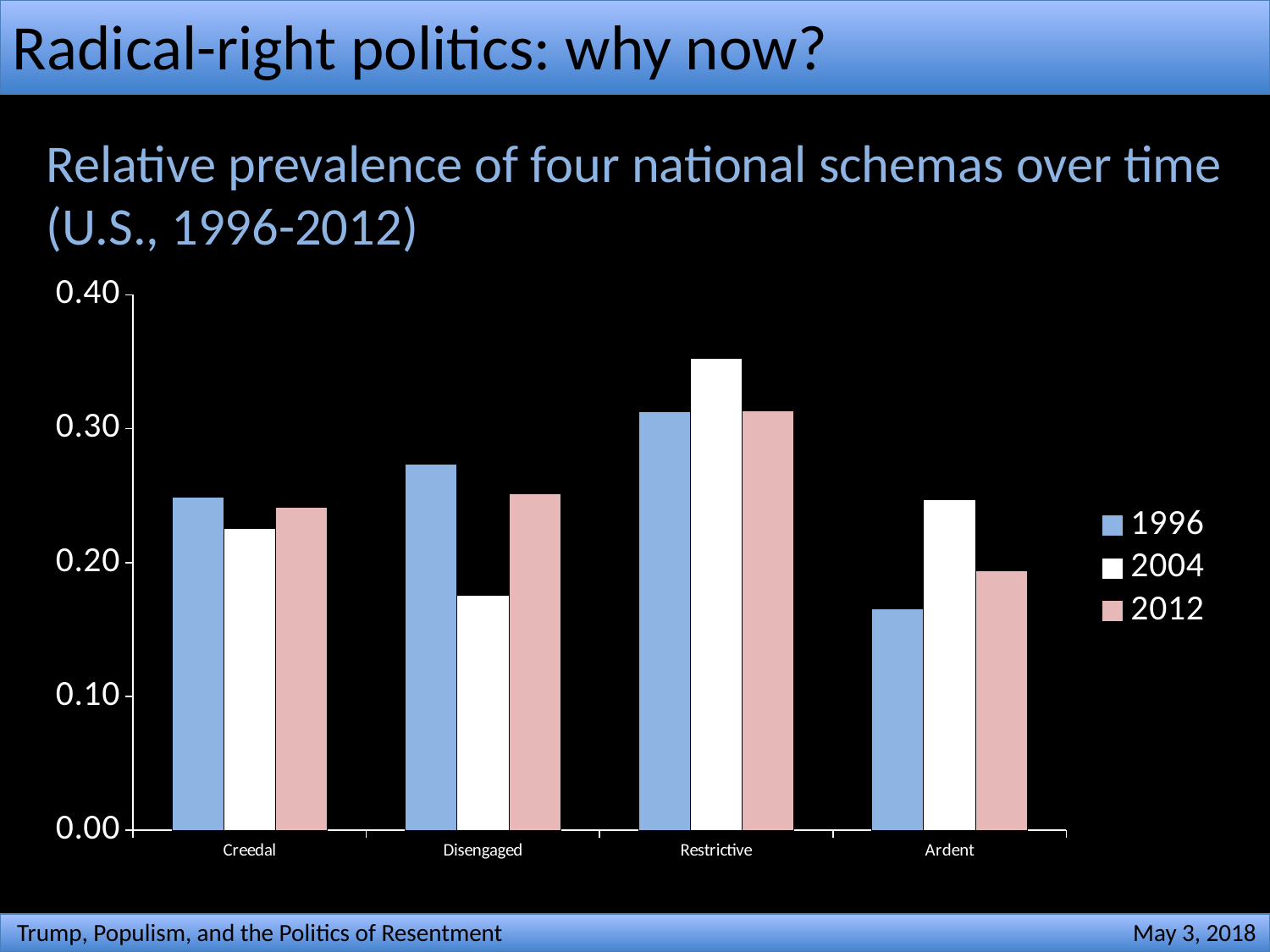
For Ardent, which is larger: the value for 2004 or the value for 2012? 2004 Which category has the lowest value for 2004? Disengaged What is the title of the chart? Relative prevalence of four national schemas over time (U.S., 1996-2012) Is the value for Ardent in 1996 greater or less than 0.20? less Is the value for Restrictive in 2004 greater or less than 0.30? greater Which category has the lowest value for 1996? Ardent Which years are listed in the chart's legend? 1996, 2004, 2012 What kind of chart is shown on the slide? bar chart For Disengaged, which is larger: the value for 1996 or the value for 2004? 1996 How many series does the chart's legend list? 3 How many categories are shown on the x axis of the chart? 4 Which category has the highest value for 2004? Restrictive